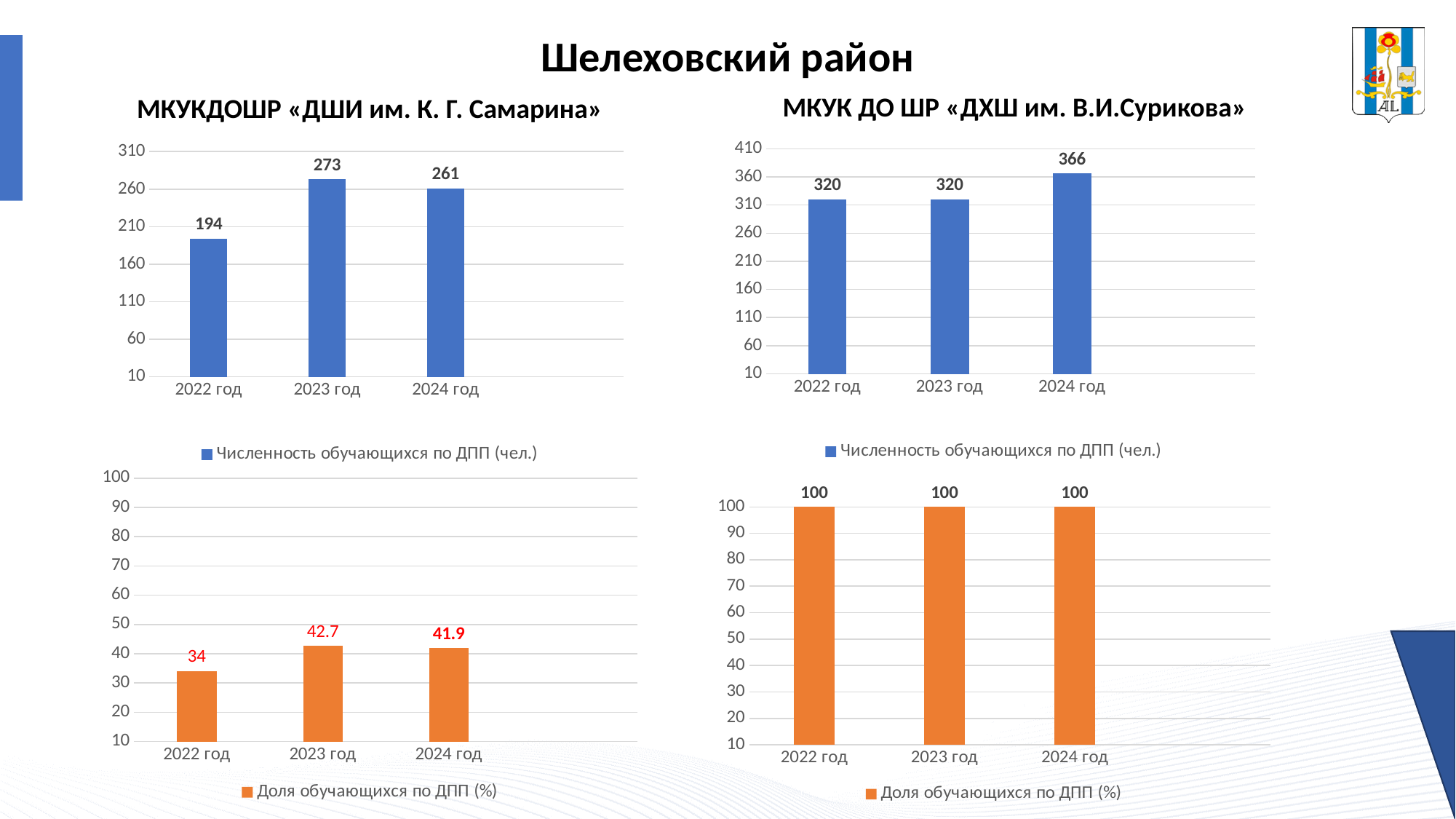
What type of chart is the top-left chart (Численность обучающихся по ДПП for ДШИ им. К. Г. Самарина)? Bar chart In the bottom-right chart (Доля обучающихся по ДПП (%) for ДХШ им. В.И.Сурикова), what is the value for 2023 год? 100 How many categories (years) are shown in the bottom-right chart (Доля обучающихся по ДПП (%) for ДХШ им. В.И.Сурикова)? 3 In the top-right chart (Численность обучающихся по ДПП for ДХШ им. В.И.Сурикова), what is the value for 2024 год? 366 In the bottom-left chart (Доля обучающихся по ДПП (%) for ДШИ им. К. Г. Самарина), which is larger, the value for 2023 год or 2024 год? 2023 год In the top-right chart (Численность обучающихся по ДПП for ДХШ им. В.И.Сурикова), which year has the highest value? 2024 год In the top-left chart (Численность обучающихся по ДПП for ДШИ им. К. Г. Самарина), what is the difference between the 2023 год and 2022 год values? 79 What is the legend entry of the bottom-left chart for ДШИ им. К. Г. Самарина? Доля обучающихся по ДПП (%) In the top-left chart (Численность обучающихся по ДПП for ДШИ им. К. Г. Самарина), which year has the lowest value? 2022 год In the bottom-left chart (Доля обучающихся по ДПП (%) for ДШИ им. К. Г. Самарина), what is the value for 2022 год? 34 In the top-left chart (Численность обучающихся по ДПП for ДШИ им. К. Г. Самарина), what is the value for 2023 год? 273 In the top-right chart (Численность обучающихся по ДПП for ДХШ им. В.И.Сурикова), what is the difference between the 2024 год and 2023 год values? 46